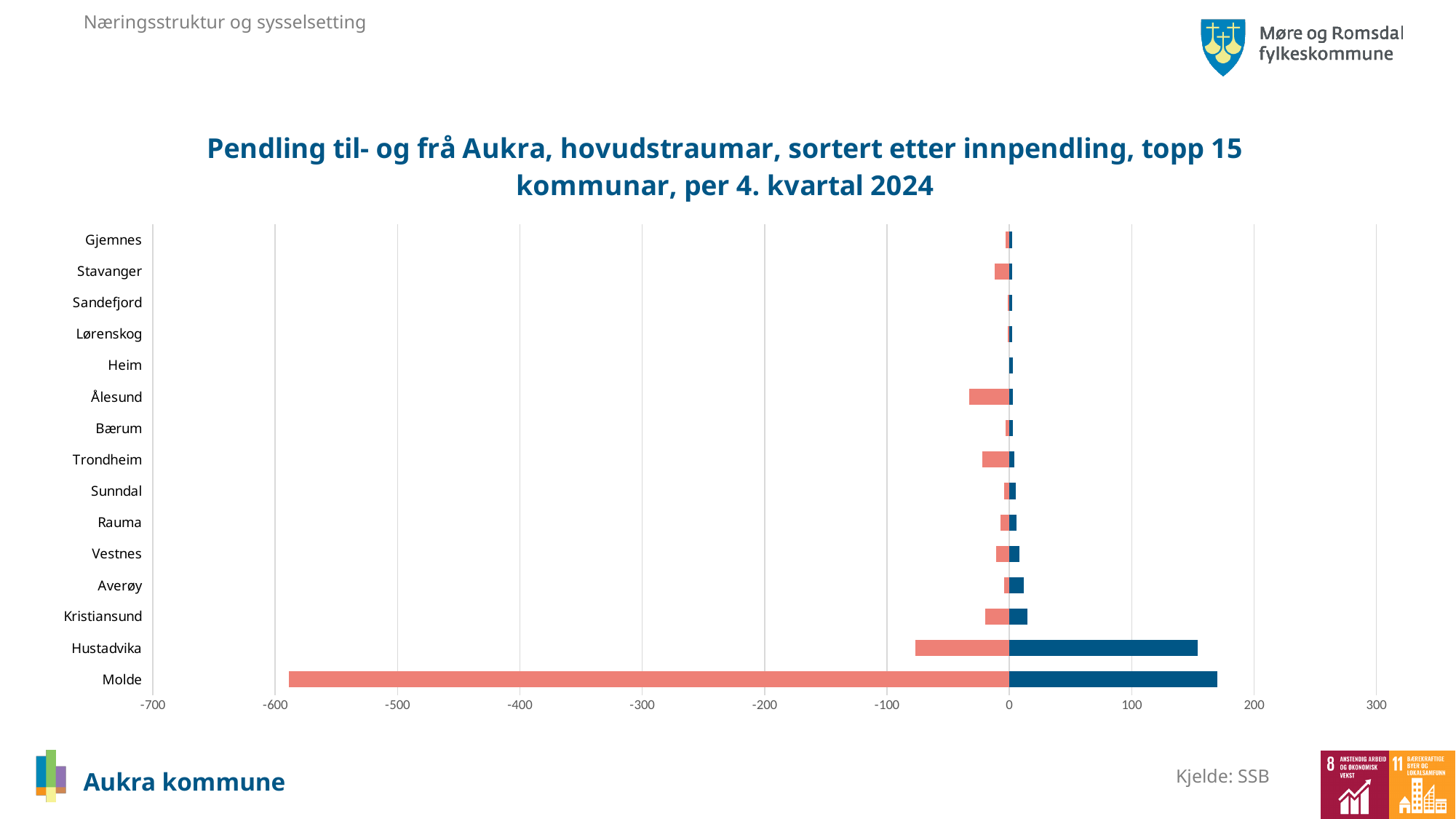
Which has the longer red (negative) bar, Ålesund or Trondheim? Ålesund Which has the longer blue (positive) bar, Molde or Hustadvika? Molde What type of chart is shown on the slide? bar chart Which municipality has the longest blue (positive) bar in the chart? Molde Is the red (negative) bar for Molde greater or less than -500? less Going from the top of the chart (Gjemnes) down to the bottom (Molde), do the blue bars get longer or shorter? longer Is the blue (positive) bar for Molde greater or less than 100? greater Is the blue (positive) bar for Kristiansund greater or less than 100? less How many municipalities (categories) are listed on the vertical axis of the chart? 15 Which municipality has the longest red (negative) bar in the chart? Molde What source is cited for the chart data on the slide? SSB